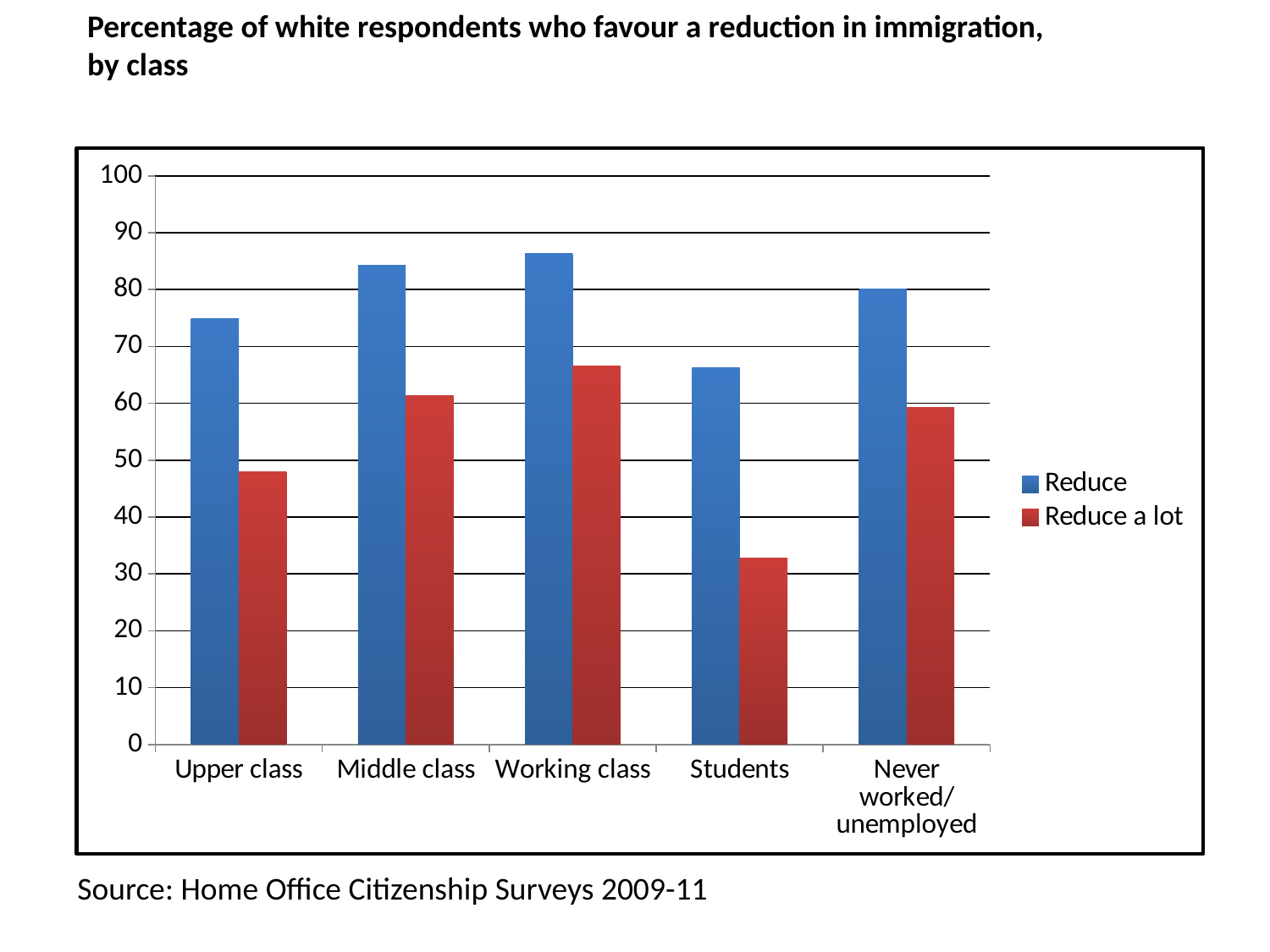
Which category has the lowest value for the Reduce a lot series? Students Is the Reduce a lot value for Middle class greater or less than 70? less How many class categories are shown on the x axis? 5 What colour are the bars for the Reduce a lot series? red What kind of chart is shown on the slide? bar chart Is the Reduce a lot value for Students greater or less than 40? less Is the Reduce value for Working class greater or less than 80? greater Which category has the highest value for the Reduce a lot series? Working class Which is larger: the Reduce value for Upper class or the Reduce value for Never worked/unemployed? Never worked/unemployed How many series does the legend list? 2 Which category has the lowest value for the Reduce series? Students